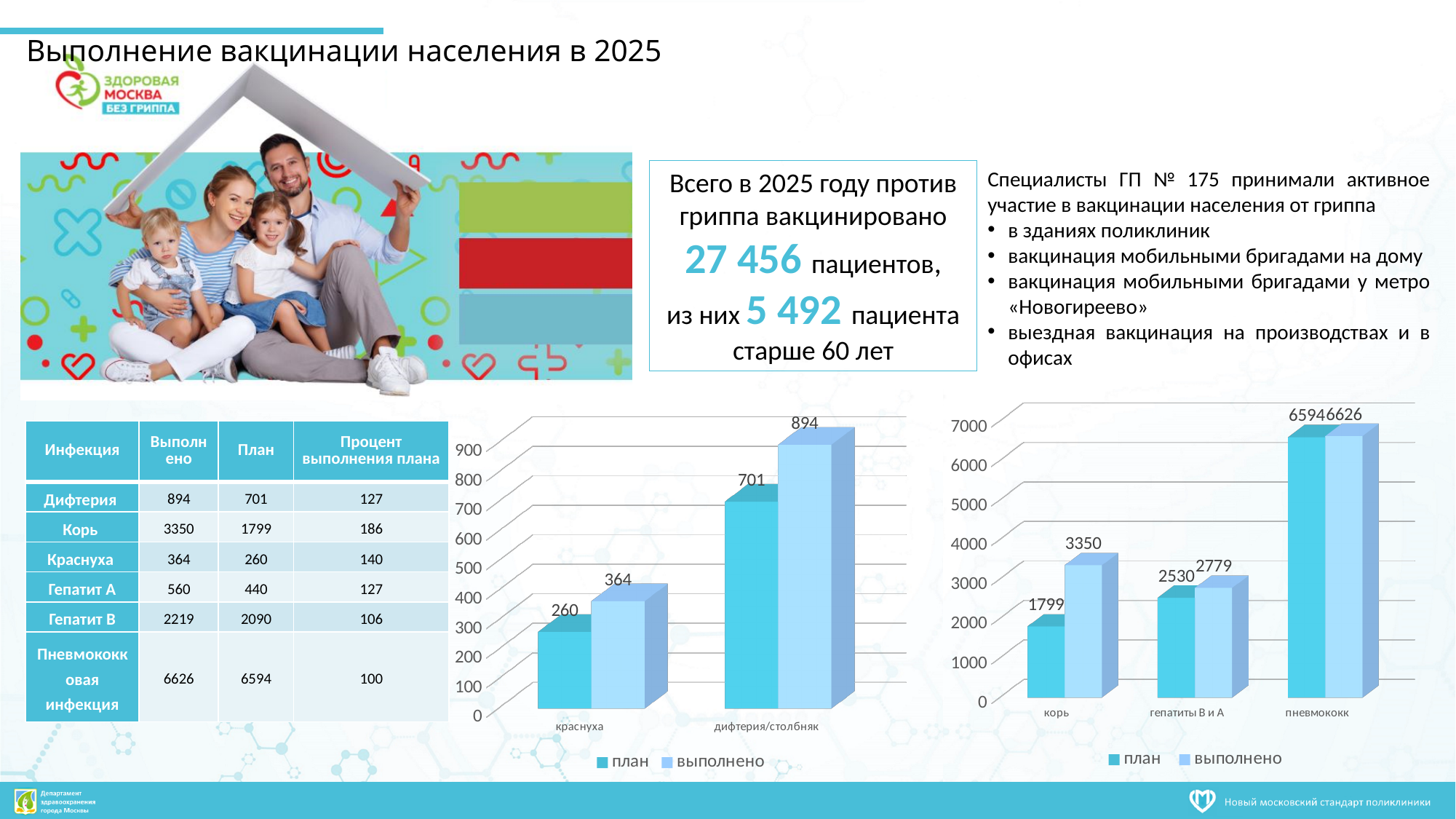
In the right chart, what is the выполнено value for гепатиты В и А? 2779 In the left chart, what is the difference between выполнено and план for краснуха? 104 In the left chart, what is the выполнено value for дифтерия/столбняк? 894 In the right chart, is the план value for пневмококк greater or less than 6000? greater In the left chart, which category has the highest выполнено value? дифтерия/столбняк In the left chart, how many categories are shown on the x axis? 2 How many series does the legend of the right chart list? 2 In the right chart, what is the план value for корь? 1799 In the left chart, what is the план value for краснуха? 260 In the right chart, which category has the lowest план value? корь In the right chart, what is the difference between выполнено and план for корь? 1551 What type of chart is the left chart? bar chart